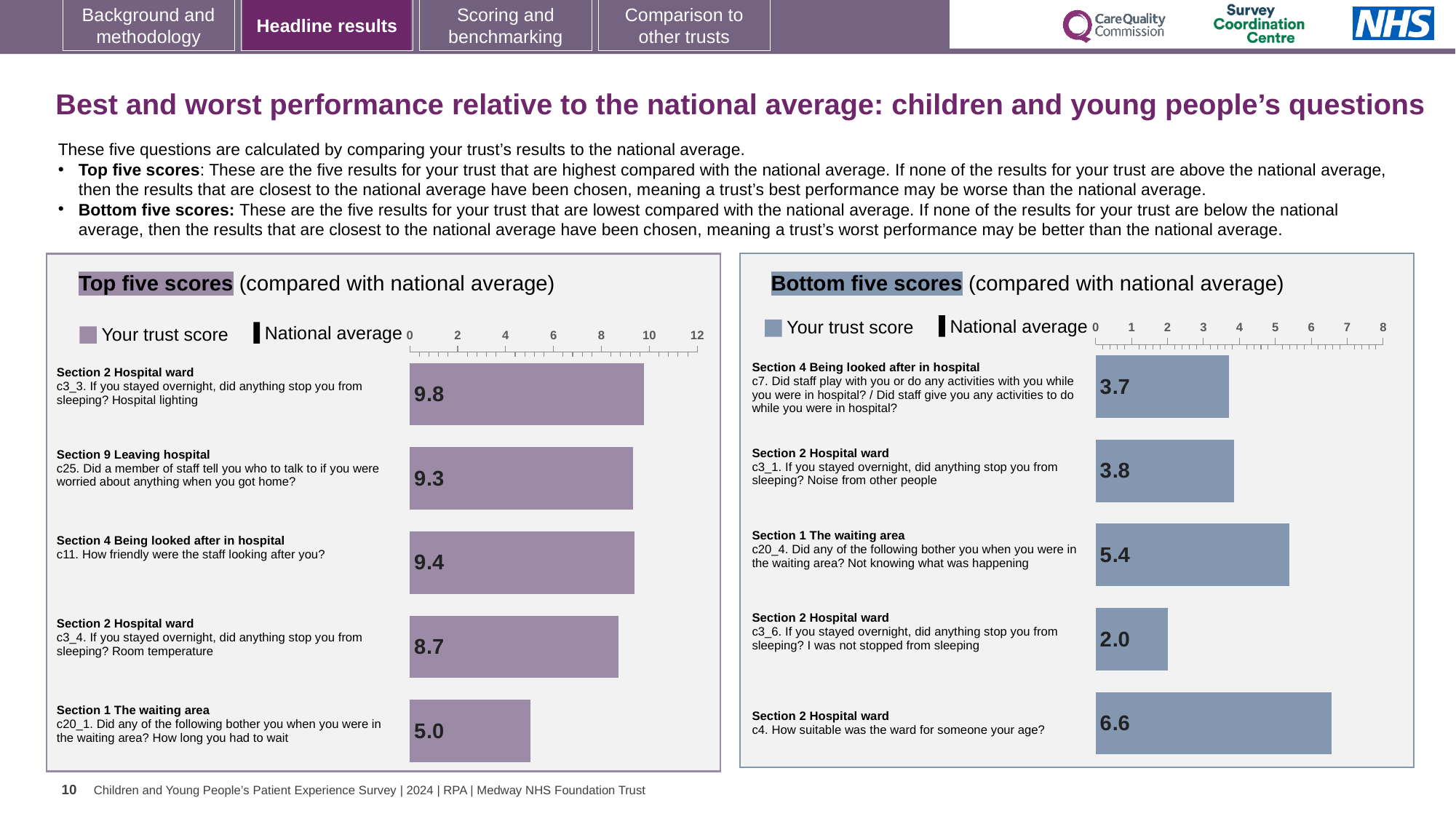
In the Bottom five scores chart, what is the trust score for c4 (how suitable was the ward for someone your age)? 6.6 In the Bottom five scores chart, what is the difference between the trust scores for c20_4 and c3_6? 3.4 In the Top five scores chart, which question has the lowest trust score? c20_1. How long you had to wait in the waiting area In the Top five scores chart, which has the larger trust score: c25 (who to talk to if worried at home) or c11 (how friendly were the staff)? c11 How many entries does the legend of the Bottom five scores chart list? 2 In the Bottom five scores chart, which question has the highest trust score? c4. How suitable was the ward for someone your age? How many questions are shown in the Bottom five scores chart? 5 In the Top five scores chart, what is the trust score for c11 (how friendly were the staff looking after you)? 9.4 In the Top five scores chart, what is the trust score for c3_3 (hospital lighting stopping you from sleeping)? 9.8 What type of chart is used in the Top five scores panel? Bar chart In the Bottom five scores chart, what is the trust score for c3_6 (I was not stopped from sleeping)? 2.0 In the Top five scores chart, what is the difference between the trust scores for c3_3 (9.8) and c3_4 (8.7)? 1.1